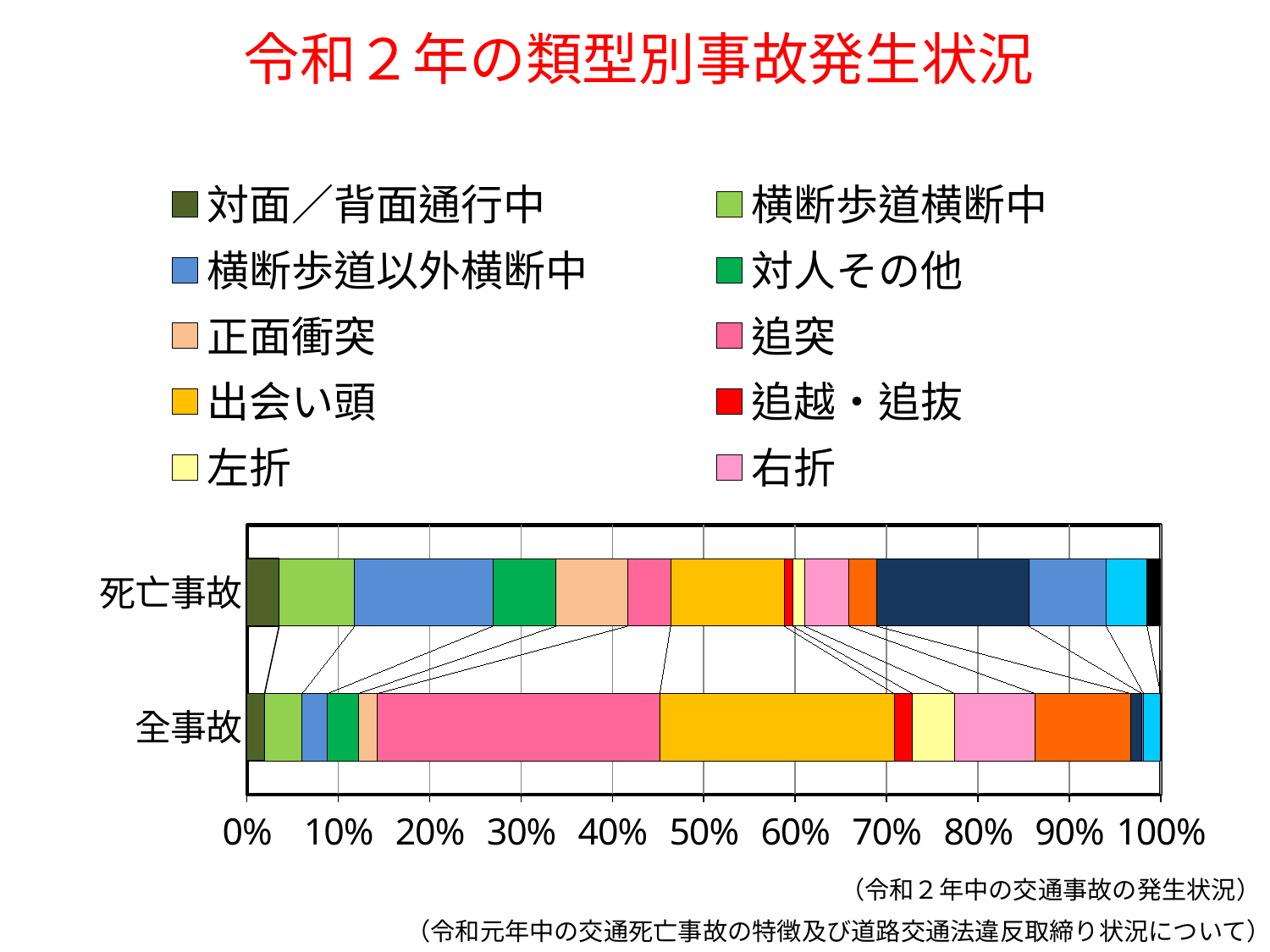
What is the highest value shown on the horizontal axis? 100% How many bars (categories) does the chart show? 2 What are the two categories shown on the vertical axis of the chart? 死亡事故 and 全事故 Is the share for 追越・追抜 in the 死亡事故 bar greater or less than 10%? less What colour does the legend use for 追突? Pink In the 全事故 bar, is the share for 追突 larger or smaller than the share for 対面／背面通行中? Larger In the 死亡事故 bar, is the share for 横断歩道以外横断中 larger or smaller than the share for 追越・追抜? Larger How many series does the legend list? 10 In the 全事故 bar, which legend series occupies the largest share? 追突 What is the title of the slide's chart? 令和２年の類型別事故発生状況 What kind of chart is shown on the slide? Stacked bar chart Is the share for 出会い頭 in the 全事故 bar greater or less than 20%? greater